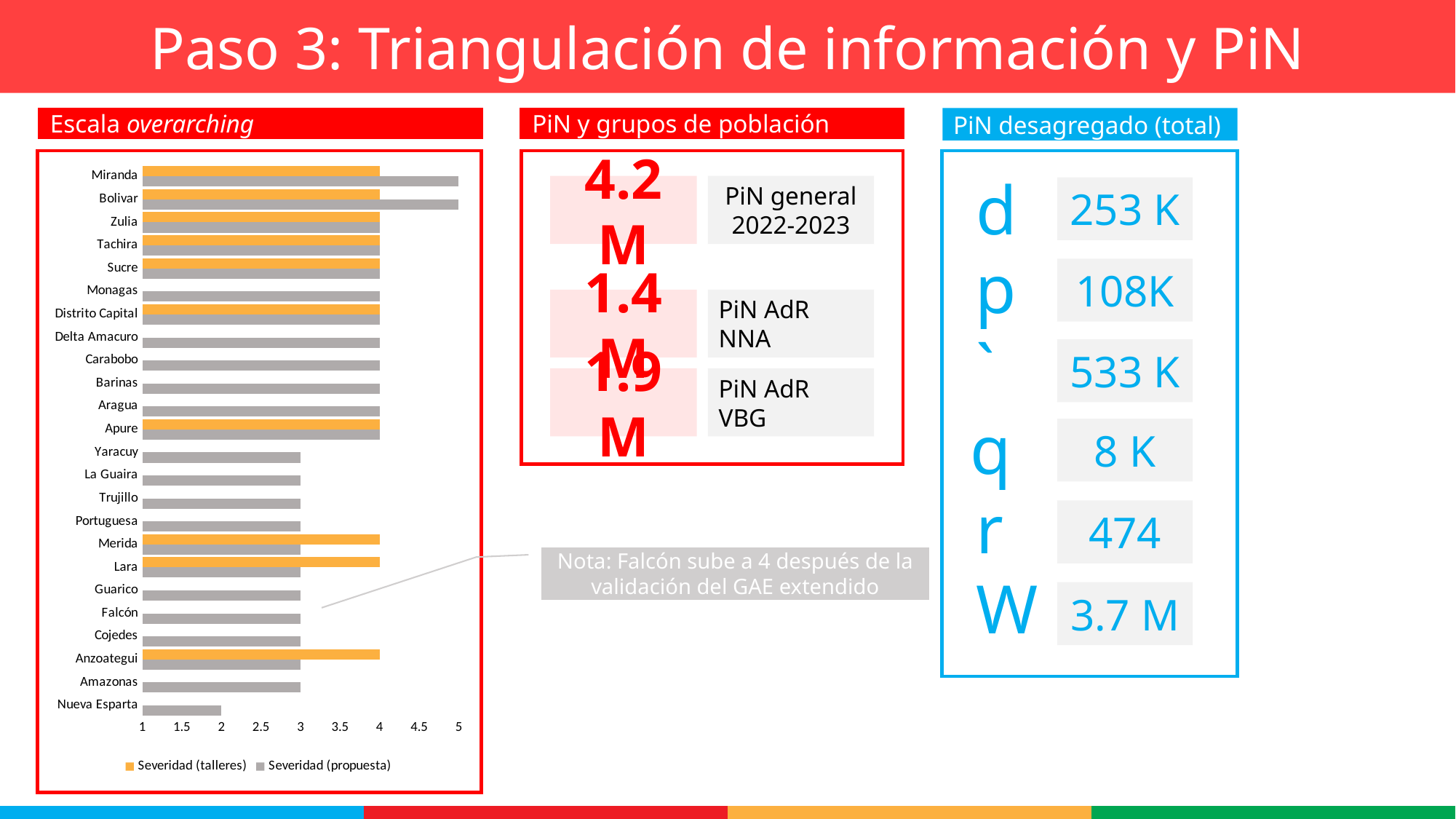
In the 'Escala overarching' chart, what colour represents Severidad (talleres)? orange In the 'Escala overarching' chart, what is the difference between the Severidad (propuesta) and Severidad (talleres) values for Miranda? 1 In the 'Escala overarching' chart, which state has the lowest Severidad (propuesta) value? Nueva Esparta In the 'Escala overarching' chart, what is the Severidad (propuesta) value for Miranda? 5 In the 'Escala overarching' chart, what is the Severidad (propuesta) value for Nueva Esparta? 2 In the 'Escala overarching' chart, is the Severidad (propuesta) value for Nueva Esparta greater or less than 3? less In the 'Escala overarching' chart, which is larger: the Severidad (propuesta) value for Bolivar or for Zulia? Bolivar In the 'Escala overarching' chart, for Merida, which is larger: Severidad (talleres) or Severidad (propuesta)? Severidad (talleres) How many states (categories) are plotted in the 'Escala overarching' chart? 24 How many series does the legend of the 'Escala overarching' chart list? 2 In the 'Escala overarching' chart, what is the Severidad (talleres) value for Lara? 4 What kind of chart is shown under 'Escala overarching'? bar chart